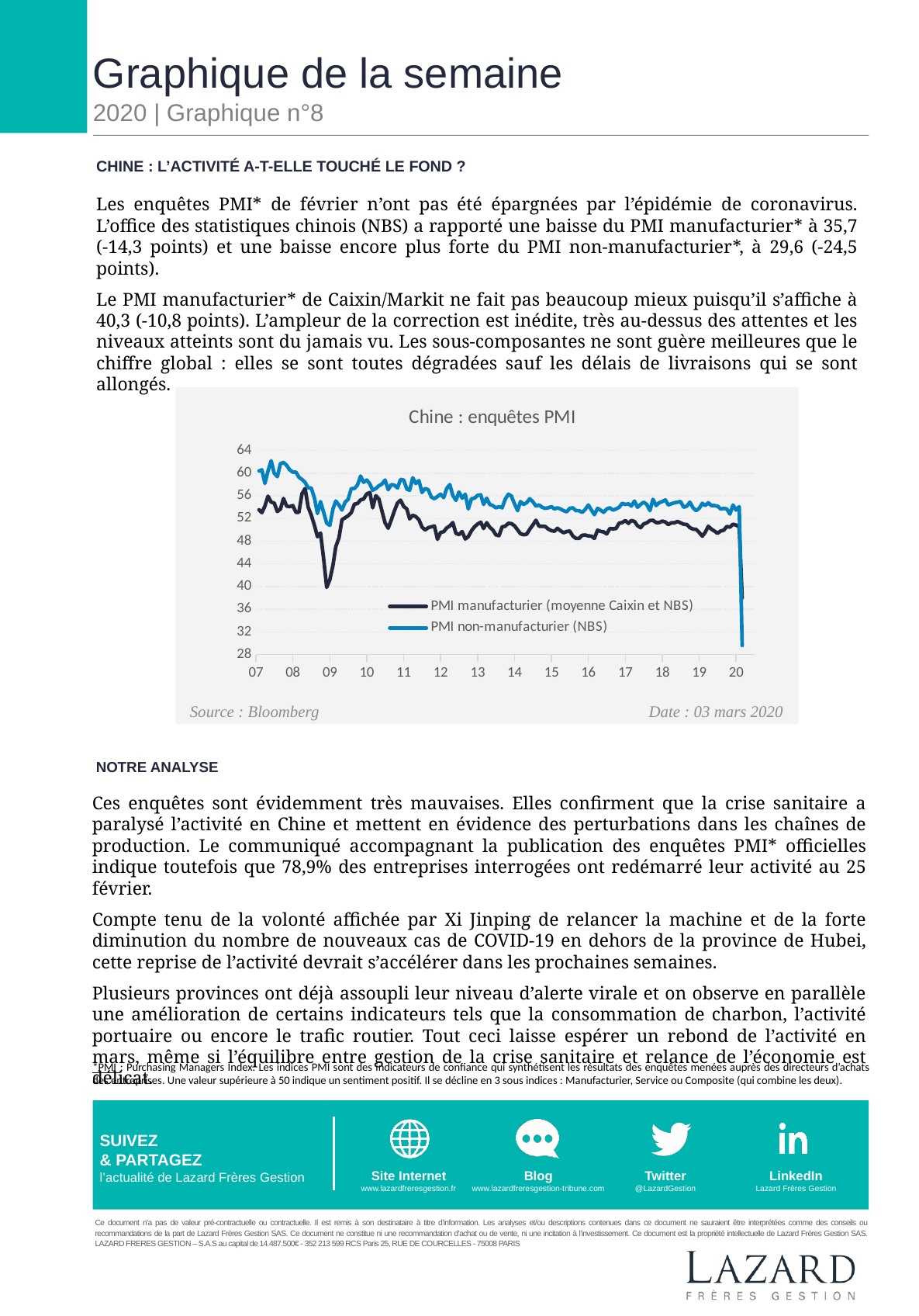
How many year labels are shown on the x axis? 14 Is the value of PMI manufacturier (moyenne Caixin et NBS) in 2019 greater or less than 56? less What kind of chart is shown on the slide? line chart Is the lowest value of PMI manufacturier (moyenne Caixin et NBS) around 2009 greater or less than 44? less Between 2010 and 2019, which series is generally higher: PMI manufacturier or PMI non-manufacturier (NBS)? PMI non-manufacturier (NBS) What is the highest value shown on the y axis? 64 How many series does the chart's legend list? 2 What is the title of the chart? Chine : enquêtes PMI Do the values of PMI non-manufacturier (NBS) overall rise or fall from 2007 to 2020? fall Is the value of PMI non-manufacturier (NBS) at the end of the series in 2020 greater or less than 32? less Which series is drawn in the dark navy line? PMI manufacturier (moyenne Caixin et NBS)